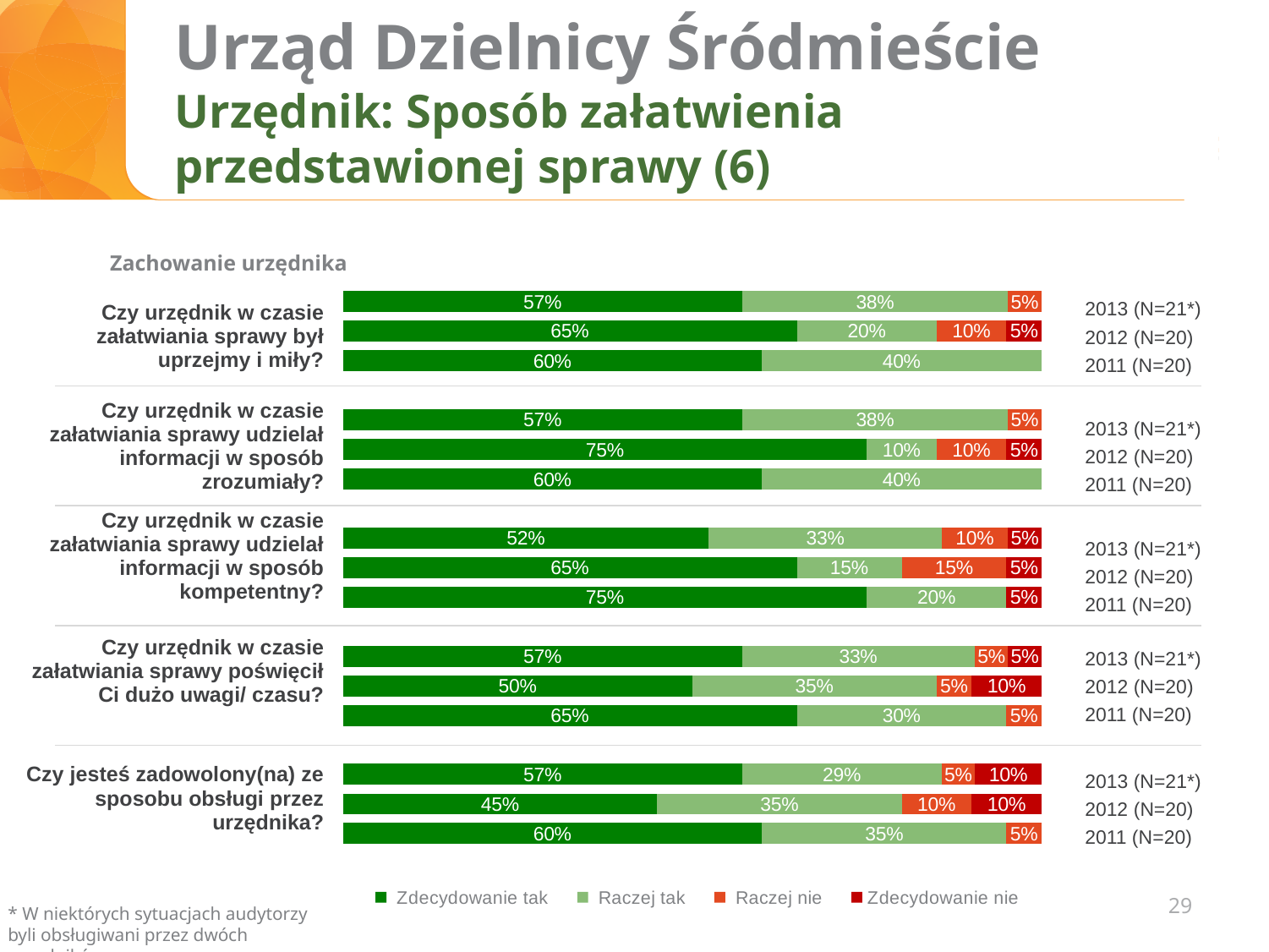
What percentage answered "Zdecydowanie tak" in 2012 to the question "Czy urzędnik w czasie załatwiania sprawy był uprzejmy i miły?"? 65% For the question "Czy urzędnik w czasie załatwiania sprawy poświęcił Ci dużo uwagi/ czasu?", which year has the larger "Raczej tak" share, 2012 or 2013? 2012 What percentage answered "Raczej tak" in 2011 to the question "Czy urzędnik w czasie załatwiania sprawy udzielał informacji w sposób zrozumiały?"? 40% What percentage answered "Zdecydowanie tak" in 2012 to the question "Czy jesteś zadowolony(na) ze sposobu obsługi przez urzędnika?"? 45% For the question "Czy urzędnik w czasie załatwiania sprawy udzielał informacji w sposób zrozumiały?", how many percentage points higher is the "Zdecydowanie tak" share in 2012 than in 2013? 18 percentage points How many response categories does the chart legend list? 4 What type of chart is shown on the slide? Stacked bar chart How many survey questions are shown in the chart? 5 What percentage answered "Raczej nie" in 2012 to the question "Czy urzędnik w czasie załatwiania sprawy udzielał informacji w sposób kompetentny?"? 15% For the question "Czy jesteś zadowolony(na) ze sposobu obsługi przez urzędnika?", which year has the lowest share of "Zdecydowanie tak"? 2012 What percentage answered "Zdecydowanie nie" in 2013 to the question "Czy jesteś zadowolony(na) ze sposobu obsługi przez urzędnika?"? 10% For the question "Czy urzędnik w czasie załatwiania sprawy udzielał informacji w sposób kompetentny?", which year has the highest share of "Zdecydowanie tak"? 2011